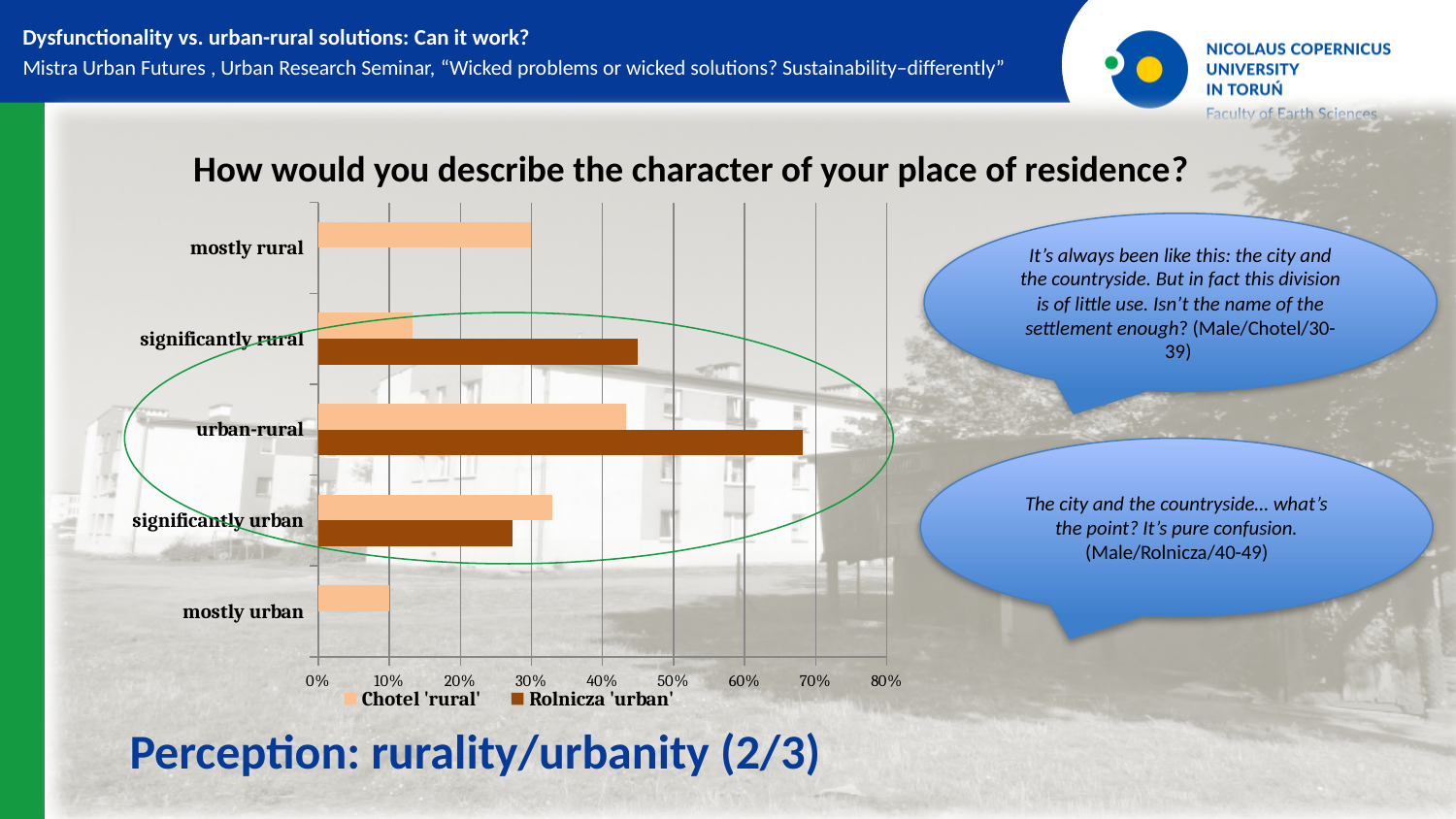
Is the Chotel 'rural' value for mostly rural greater or less than 40%? less Is the Rolnicza 'urban' value for urban-rural greater or less than 60%? greater How many response categories are shown on the chart's vertical axis? 5 For the Chotel 'rural' series, which category has the highest value? urban-rural How many series does the chart legend list? 2 For the Rolnicza 'urban' series, which category has the highest value? urban-rural For the urban-rural category, which series has the larger value, Chotel 'rural' or Rolnicza 'urban'? Rolnicza 'urban' Is the Chotel 'rural' value for significantly rural greater or less than 20%? less Which two series are listed in the chart legend? Chotel 'rural' and Rolnicza 'urban' What kind of chart is shown on the slide? bar chart For the significantly rural category, which series has the larger value, Chotel 'rural' or Rolnicza 'urban'? Rolnicza 'urban' What is the title of the chart? How would you describe the character of your place of residence?